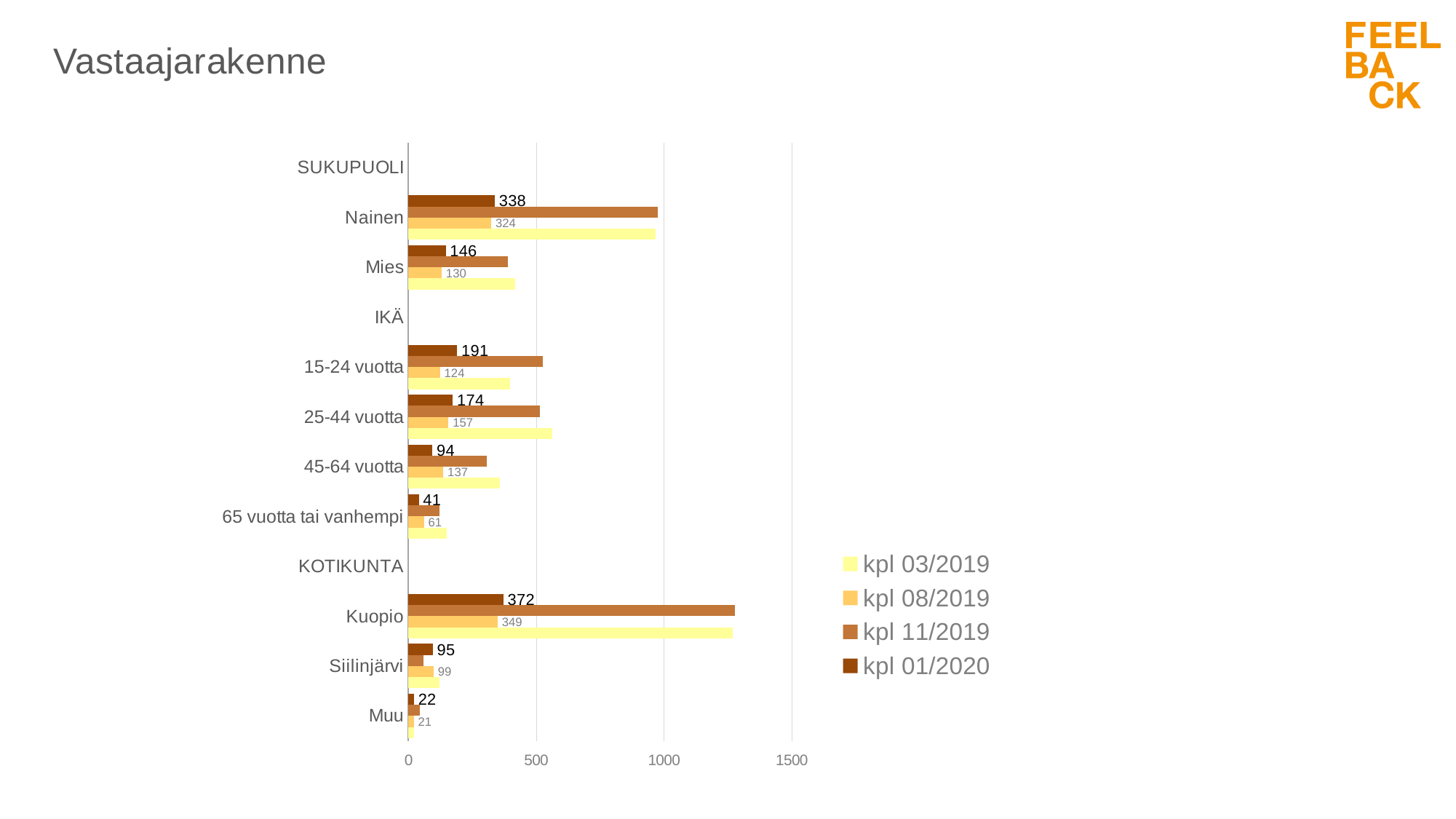
What kind of chart is shown on the slide? Bar chart Which category has the highest kpl 01/2020 value? Kuopio Is the kpl 11/2019 value for Nainen greater or less than 500? greater Is the kpl 03/2019 value for Kuopio greater or less than 1000? greater What is the difference between the kpl 01/2020 and kpl 08/2019 values for Mies? 16 What is the kpl 01/2020 value for 45-64 vuotta? 94 What is the kpl 08/2019 value for Kuopio? 349 What is the kpl 01/2020 value for Nainen? 338 What is the kpl 08/2019 value for 65 vuotta tai vanhempi? 61 Which category has the lowest kpl 01/2020 value? Muu How many series does the legend list? 4 Which is larger for 45-64 vuotta: the kpl 01/2020 value or the kpl 08/2019 value? kpl 08/2019